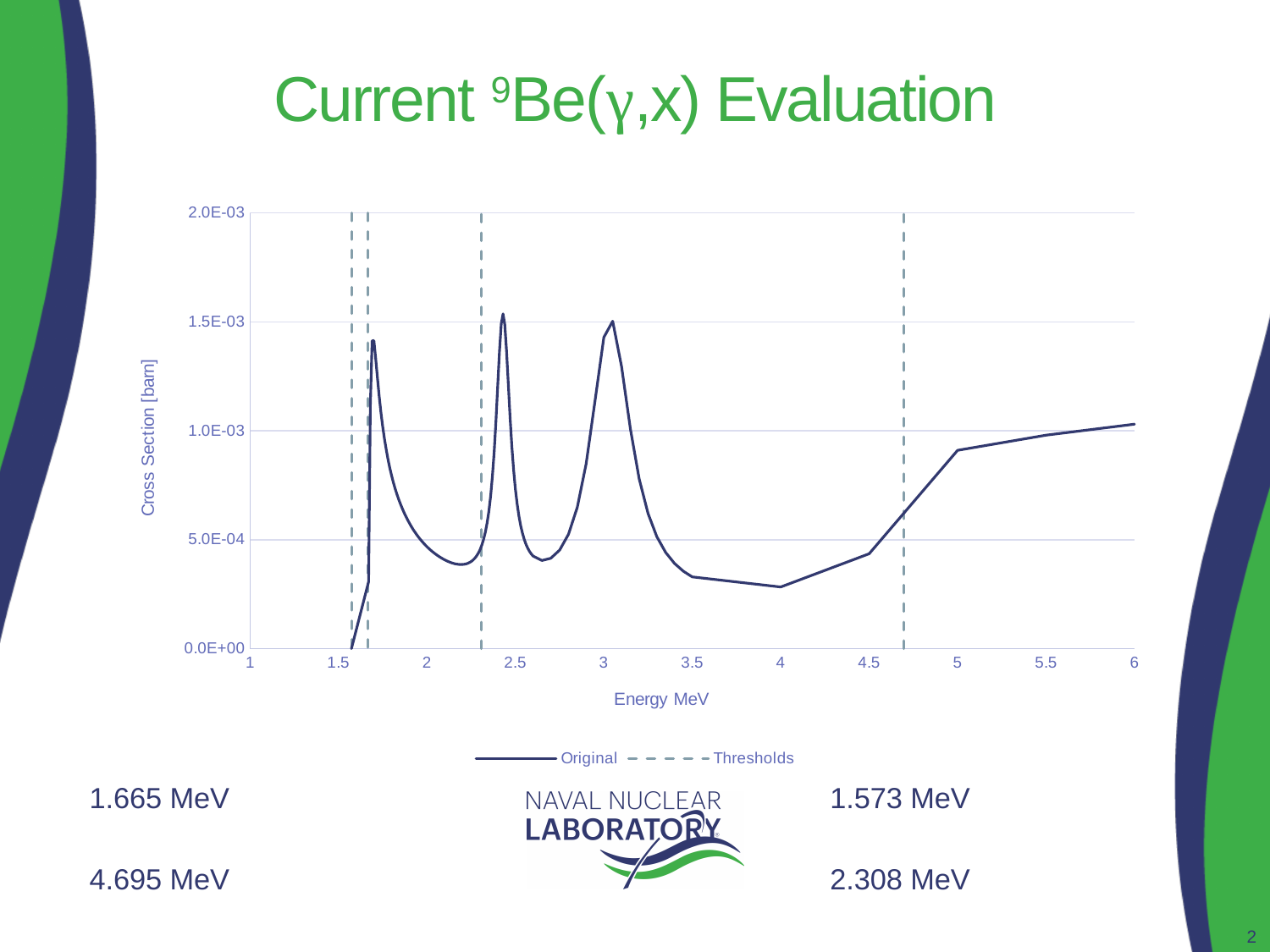
Which has the larger cross section on the Original curve: 4 MeV or 6 MeV? 6 MeV Is the cross section of the Original curve at 4 MeV greater or less than 5.0E-04 barn? less Is the cross section of the Original curve at 5 MeV greater or less than 1.0E-03 barn? less Is the first peak of the Original curve, near 1.7 MeV, greater or less than 1.5E-03 barn? less How many series does the legend list? 2 Does the Original curve rise or fall as energy increases from 4 MeV to 6 MeV? rise What is the label of the y axis? Cross Section [barn] How many dashed vertical threshold lines are drawn on the chart? 4 What kind of chart is shown on the slide? line chart What are the two entries in the chart legend? Original and Thresholds